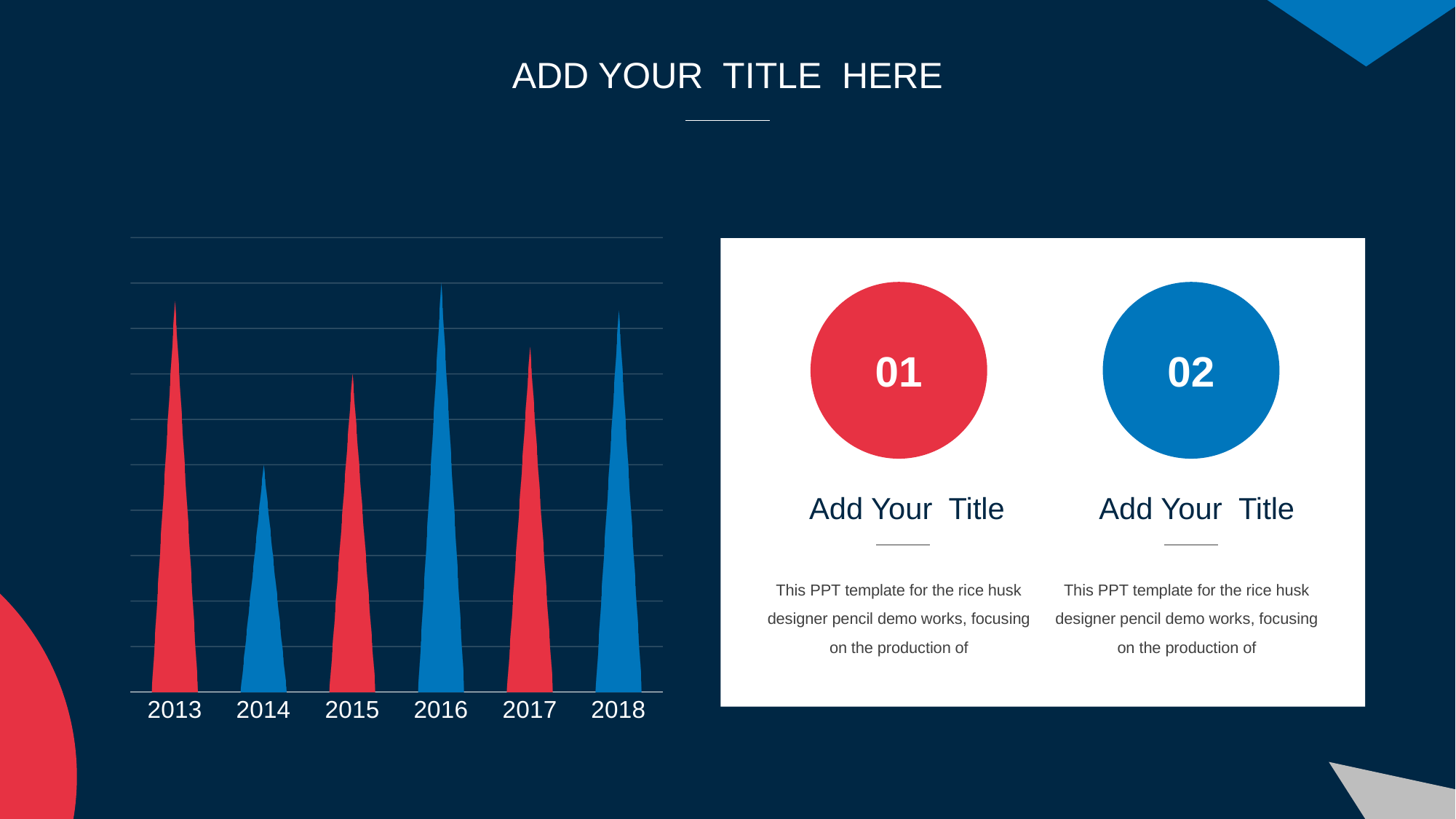
What kind of chart is shown on the left of the slide? bar chart Which is larger in the chart, the value for 2014 or the value for 2015? 2015 Which year has the highest bar in the chart? 2016 Which is larger in the chart, the value for 2016 or the value for 2017? 2016 Which is larger in the chart, the value for 2014 or the value for 2018? 2018 How many years are shown on the x axis of the chart? 6 Which year has the lowest bar in the chart? 2014 What is the first year shown on the x axis of the chart? 2013 What colour is the bar for 2016 in the chart? blue